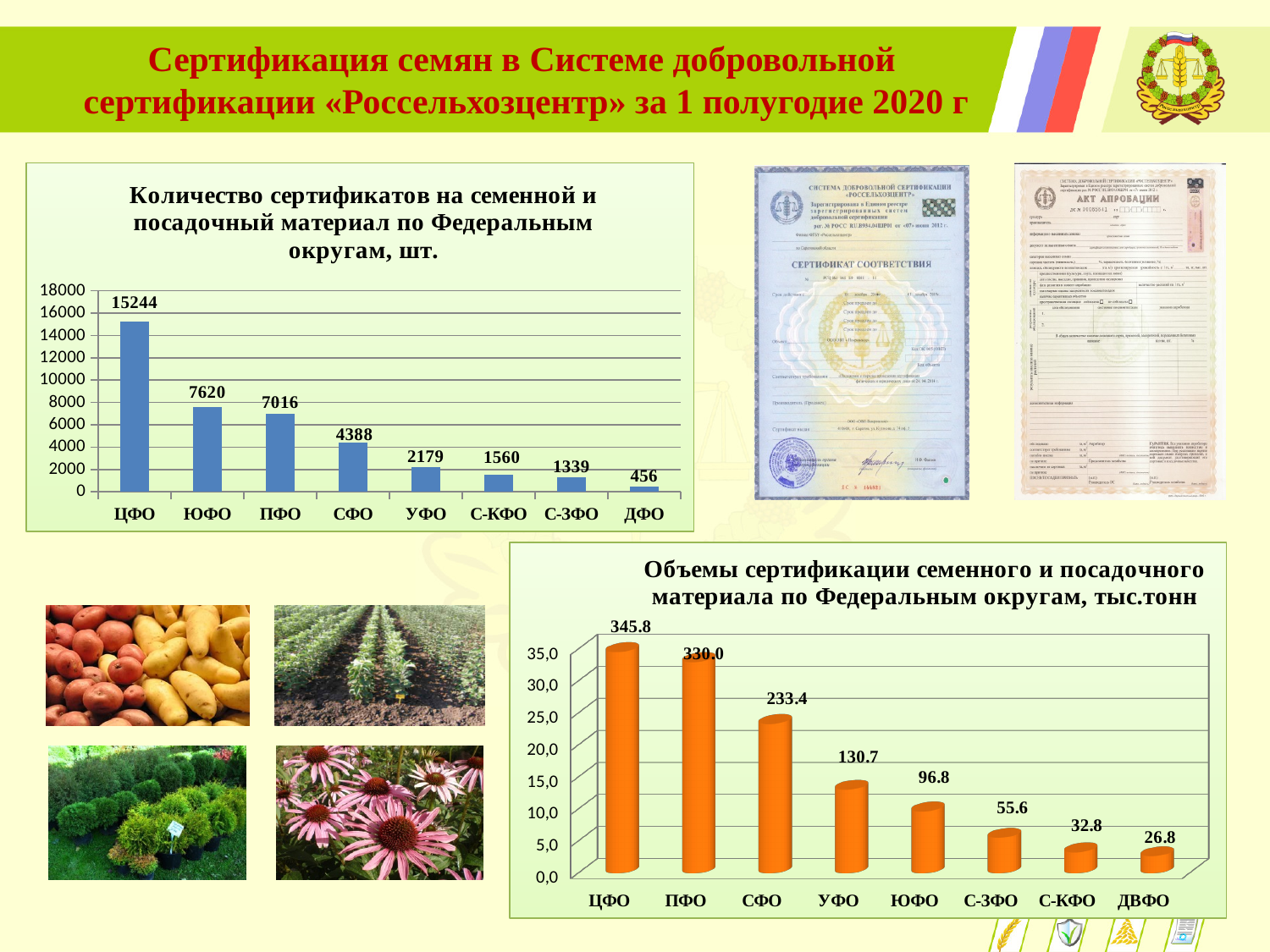
In the chart 'Объемы сертификации семенного и посадочного материала по Федеральным округам, тыс.тонн', what is the difference between УФО and ЮФО? 33.9 In the chart 'Количество сертификатов на семенной и посадочный материал по Федеральным округам, шт.', what is the value for СФО? 4388 In the chart 'Количество сертификатов на семенной и посадочный материал по Федеральным округам, шт.', which federal district has the lowest value? ДФО In the chart 'Количество сертификатов на семенной и посадочный материал по Федеральным округам, шт.', what is the value for ЦФО? 15244 In the chart 'Количество сертификатов на семенной и посадочный материал по Федеральным округам, шт.', what is the difference between ЮФО and ПФО? 604 In the chart 'Объемы сертификации семенного и посадочного материала по Федеральным округам, тыс.тонн', do the values rise or fall from left to right along the x axis? Fall In the chart 'Объемы сертификации семенного и посадочного материала по Федеральным округам, тыс.тонн', what is the value for ПФО? 330.0 What type of chart is 'Количество сертификатов на семенной и посадочный материал по Федеральным округам, шт.'? Bar chart In the chart 'Объемы сертификации семенного и посадочного материала по Федеральным округам, тыс.тонн', what is the value for ДВФО? 26.8 In the chart 'Объемы сертификации семенного и посадочного материала по Федеральным округам, тыс.тонн', which federal district has the highest value? ЦФО In the chart 'Количество сертификатов на семенной и посадочный материал по Федеральным округам, шт.', how many federal districts are shown? 8 In the chart 'Количество сертификатов на семенной и посадочный материал по Федеральным округам, шт.', which is larger, С-КФО or С-ЗФО? С-КФО